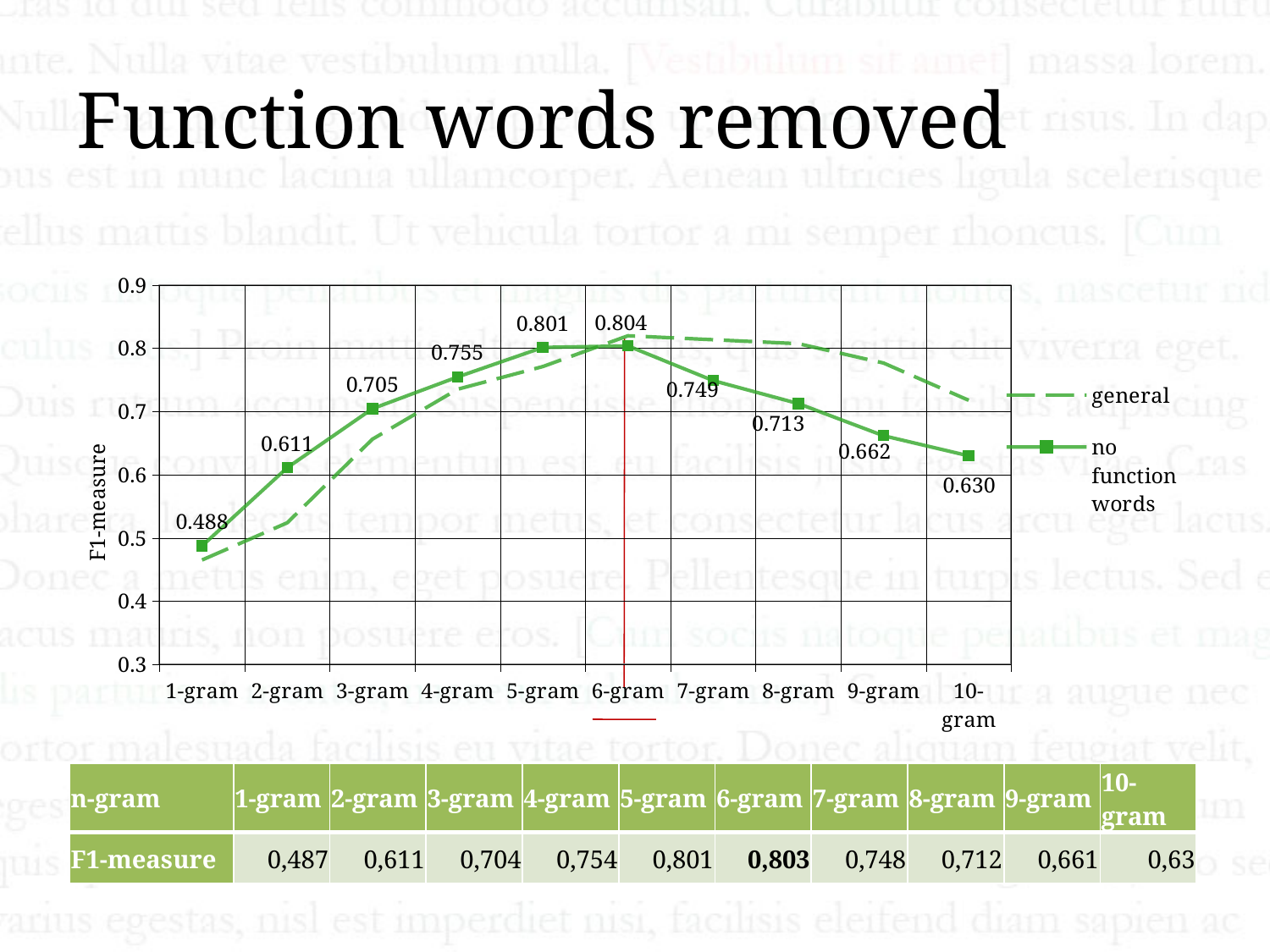
For the 'no function words' series, which is larger: the F1-measure at 4-gram or at 8-gram? 4-gram Is the value of the 'general' series at 3-gram greater or less than 0.6? greater What is the F1-measure for the 'no function words' series at 1-gram? 0.488 What is the F1-measure for the 'no function words' series at 6-gram? 0.804 What kind of chart is shown on the slide? line chart At which n-gram does the 'no function words' series have its lowest F1-measure? 1-gram What is the F1-measure for the 'no function words' series at 10-gram? 0.630 How many n-gram categories are shown on the x axis of the chart? 10 Does the 'no function words' series rise or fall from 6-gram to 10-gram? fall At which n-gram does the 'no function words' series reach its highest F1-measure? 6-gram How many series does the chart legend list? 2 What is the difference between the 'no function words' F1-measure at 6-gram and at 1-gram? 0.316